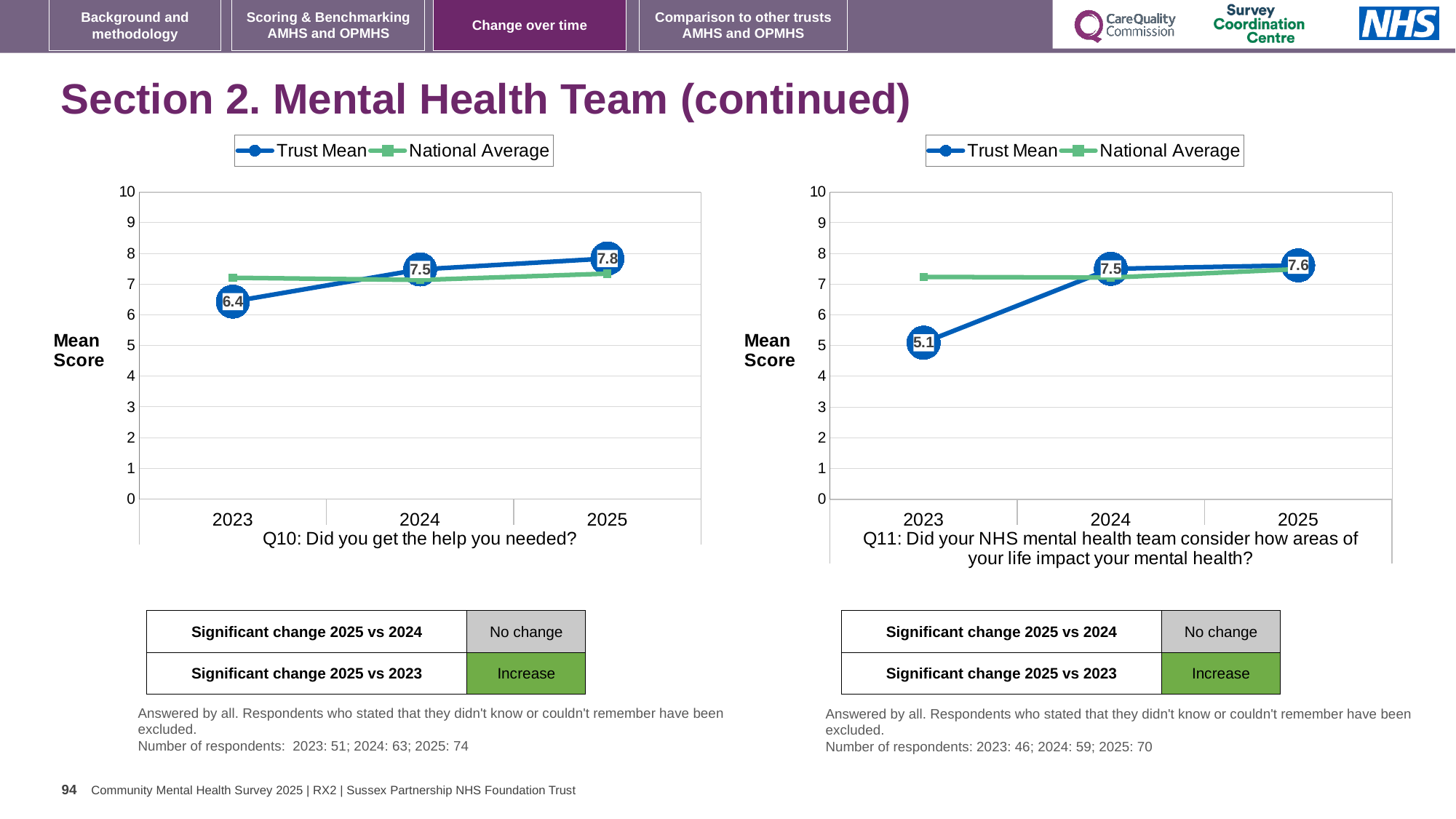
In the Q11 chart (right), what is the Trust Mean score for 2023? 5.1 In the Q11 chart (right), which year has the lowest Trust Mean score? 2023 How many series does the legend of the Q10 chart (left) list? 2 In the Q10 chart (left), what is the Trust Mean score for 2025? 7.8 In the Q10 chart (left), does the Trust Mean rise or fall from 2023 to 2025? rise In the Q11 chart (right), is the National Average for 2023 greater or less than 6? greater In the Q10 chart (left), which year has the highest Trust Mean score? 2025 In the Q11 chart (right), what is the Trust Mean score for 2024? 7.5 In the Q10 chart (left), what is the Trust Mean score for 2023? 6.4 In the Q10 chart (left), what is the difference between the Trust Mean scores for 2025 and 2023? 1.4 What type of chart is the Q11 chart (right)? line chart In the Q11 chart (right), what is the difference between the Trust Mean scores for 2024 and 2023? 2.4